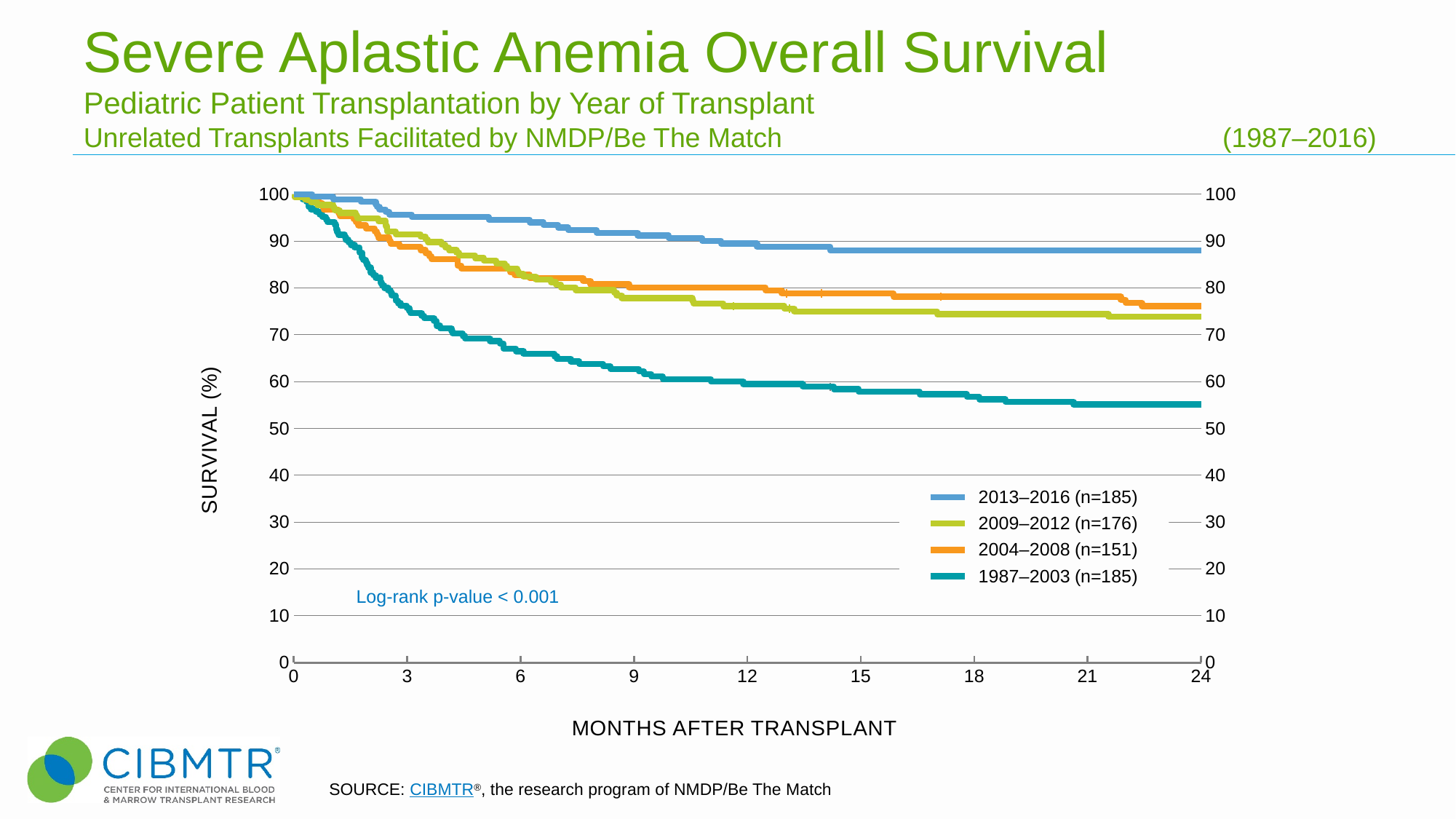
What log-rank p-value is printed on the chart? < 0.001 Is the survival for the 1987–2003 cohort at 12 months greater or less than 70? less Is the survival for the 2013–2016 cohort at 24 months greater or less than 80? greater How many series does the legend list? 4 Which transplant-year cohort has the highest survival at 24 months after transplant? 2013–2016 Is the survival for the 2009–2012 cohort at 24 months greater or less than 80? less At 24 months after transplant, which cohort has higher survival: 2013–2016 or 1987–2003? 2013–2016 Do the survival curves rise or fall as months after transplant increase? fall How many patients (n) are in the 2009–2012 cohort according to the legend? 176 Which transplant-year cohort has the lowest survival at 24 months after transplant? 1987–2003 What kind of chart is shown on the slide? line chart